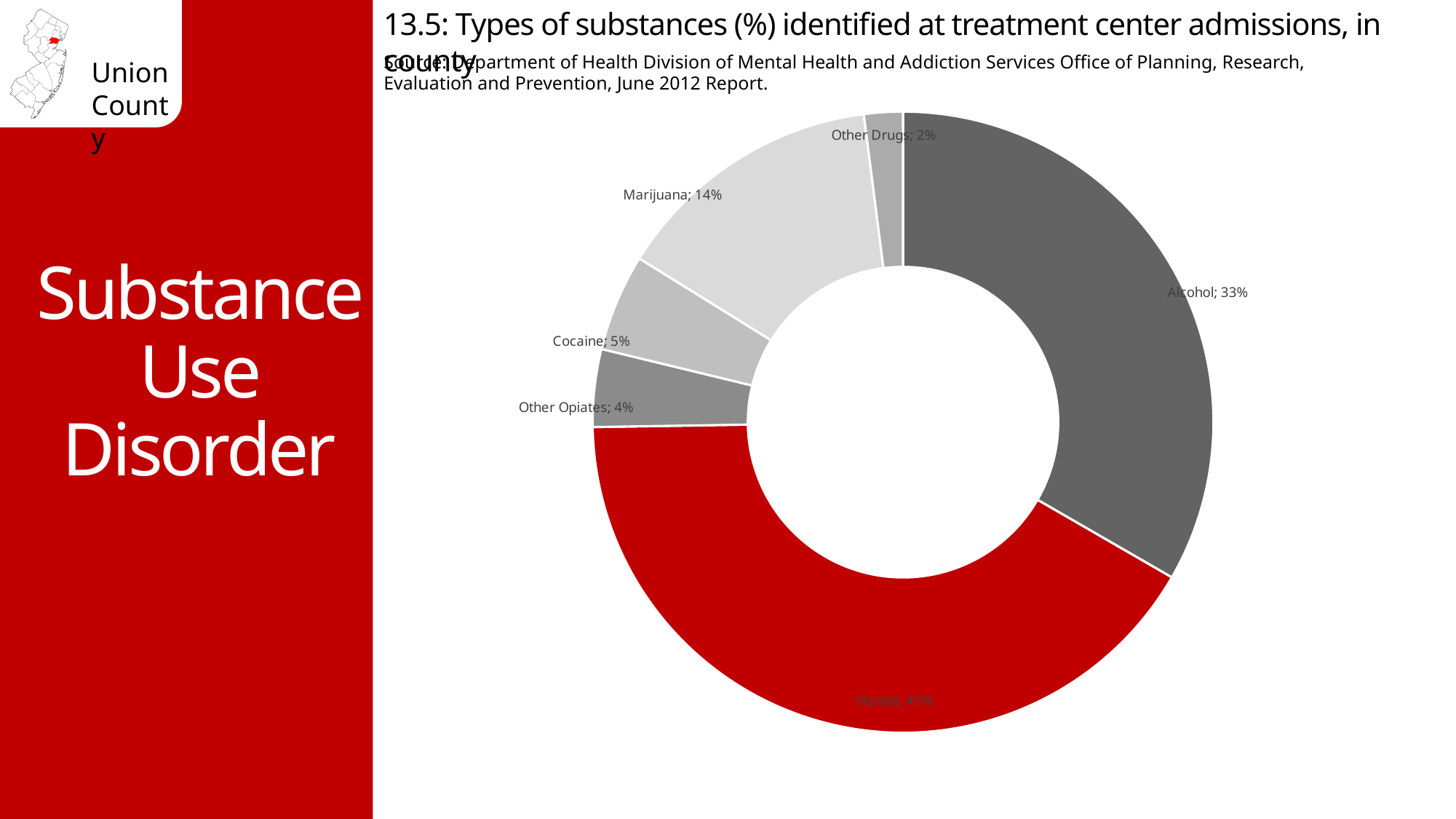
Which substance has the smallest share of admissions? Other Drugs Which has a larger share, Marijuana or Cocaine? Marijuana Which substance has the largest share of admissions? Heroin What percentage is shown for Cocaine? 5% What percentage of treatment center admissions is attributed to Alcohol? 33% What percentage is shown for Other Opiates? 4% What percentage is shown for Marijuana? 14% How many substance categories are shown in the chart? 6 What percentage is shown for Other Drugs? 2% What colour is the Heroin slice? Red What is the difference in percentage points between Heroin and Alcohol? 8 What kind of chart is used on this slide? Doughnut (pie) chart